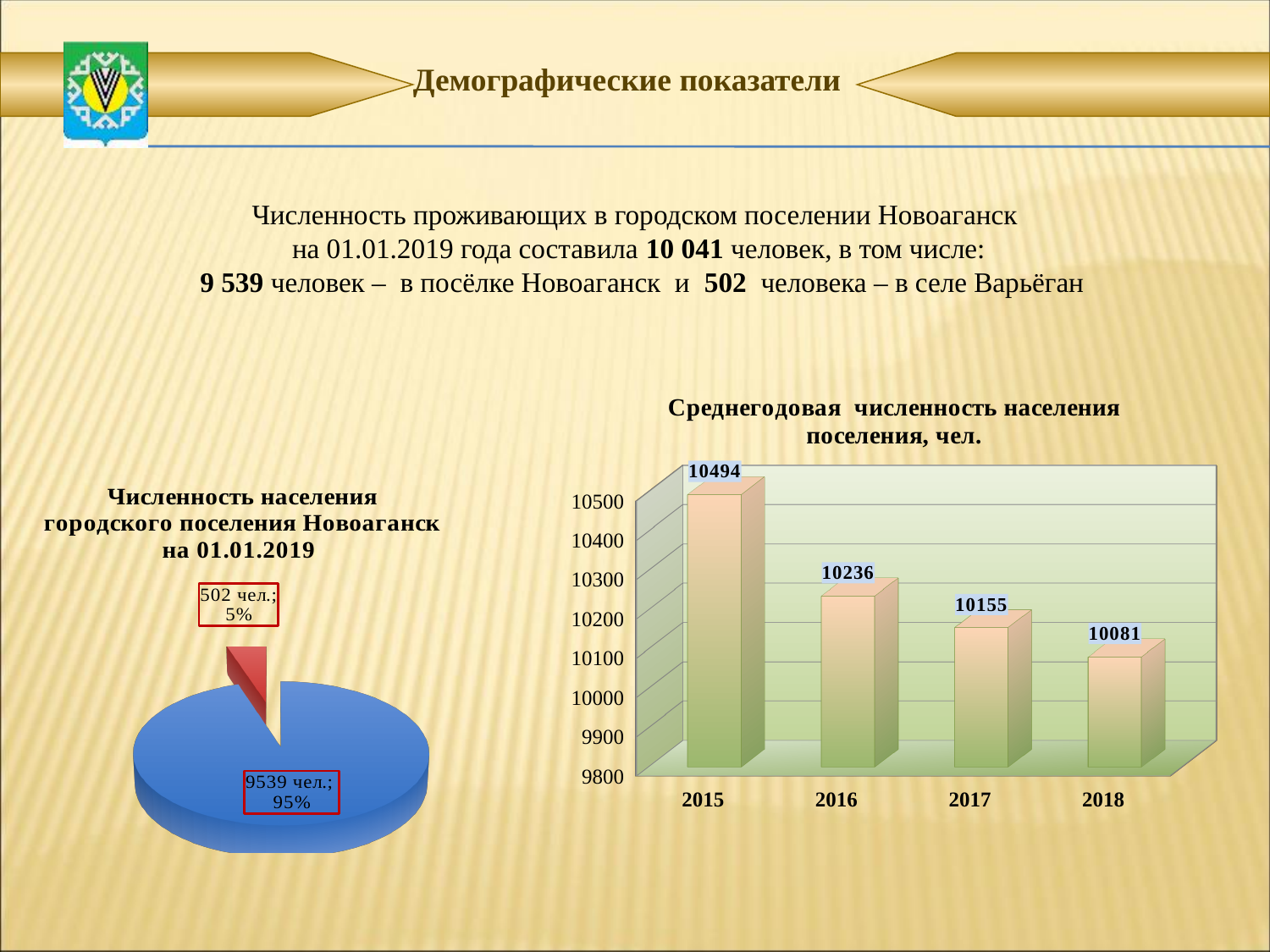
What kind of chart is the chart on the left of the slide, 'Численность населения городского поселения Новоаганск на 01.01.2019'? pie chart In the bar chart 'Среднегодовая численность населения поселения, чел.', which year has the highest value? 2015 How many years are shown in the bar chart 'Среднегодовая численность населения поселения, чел.'? 4 What kind of chart is the chart on the right of the slide, 'Среднегодовая численность населения поселения, чел.'? bar chart In the bar chart 'Среднегодовая численность населения поселения, чел.', what is the difference between the values for 2015 and 2018? 413 In the bar chart 'Среднегодовая численность населения поселения, чел.', what is the value for 2015? 10494 In the bar chart 'Среднегодовая численность населения поселения, чел.', which year has the lowest value? 2018 In the pie chart 'Численность населения городского поселения Новоаганск на 01.01.2019', what share of the pie does the larger (blue) slice represent? 95% In the bar chart 'Среднегодовая численность населения поселения, чел.', do the values rise or fall from 2015 to 2018? fall In the bar chart 'Среднегодовая численность населения поселения, чел.', which is larger, the value for 2016 or the value for 2017? 2016 In the bar chart 'Среднегодовая численность населения поселения, чел.', what is the value for 2018? 10081 In the pie chart 'Численность населения городского поселения Новоаганск на 01.01.2019', what value is labelled on the smaller (red) slice? 502 чел.